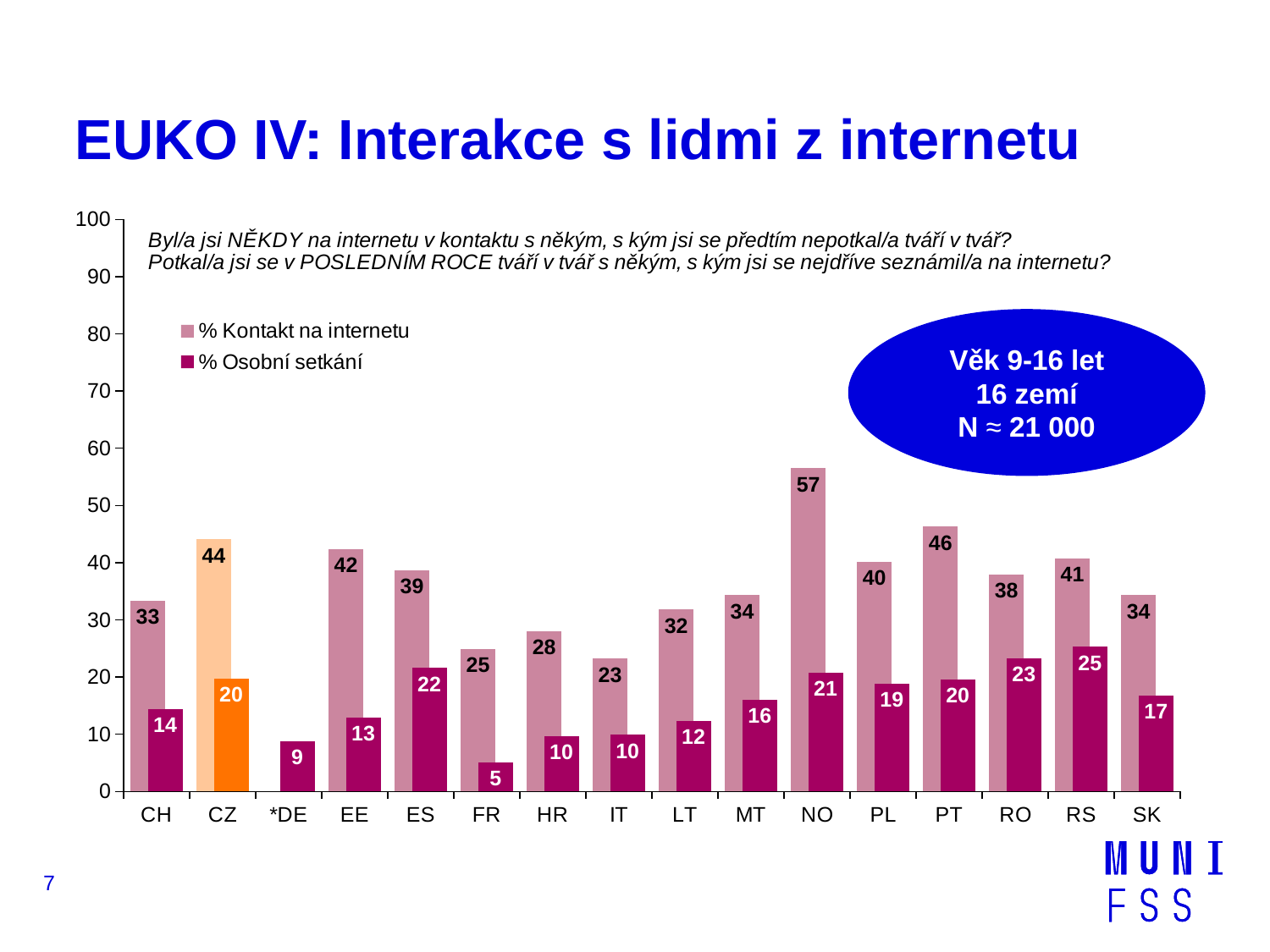
What is the value of "% Kontakt na internetu" for NO? 57 How many countries are shown on the x axis? 16 What kind of chart is shown on the slide? Bar chart How many series does the legend list? 2 Which country has the highest value for "% Kontakt na internetu"? NO What is the value of "% Osobní setkání" for FR? 5 What is the value of "% Osobní setkání" for CZ? 20 Which country has the lowest value for "% Osobní setkání"? FR What is the difference between the "% Kontakt na internetu" and "% Osobní setkání" values for CZ? 24 Which is larger: the "% Kontakt na internetu" value for PT or for PL? PT Which country has the highest value for "% Osobní setkání"? RS Is the "% Kontakt na internetu" value for EE greater or less than 40? greater